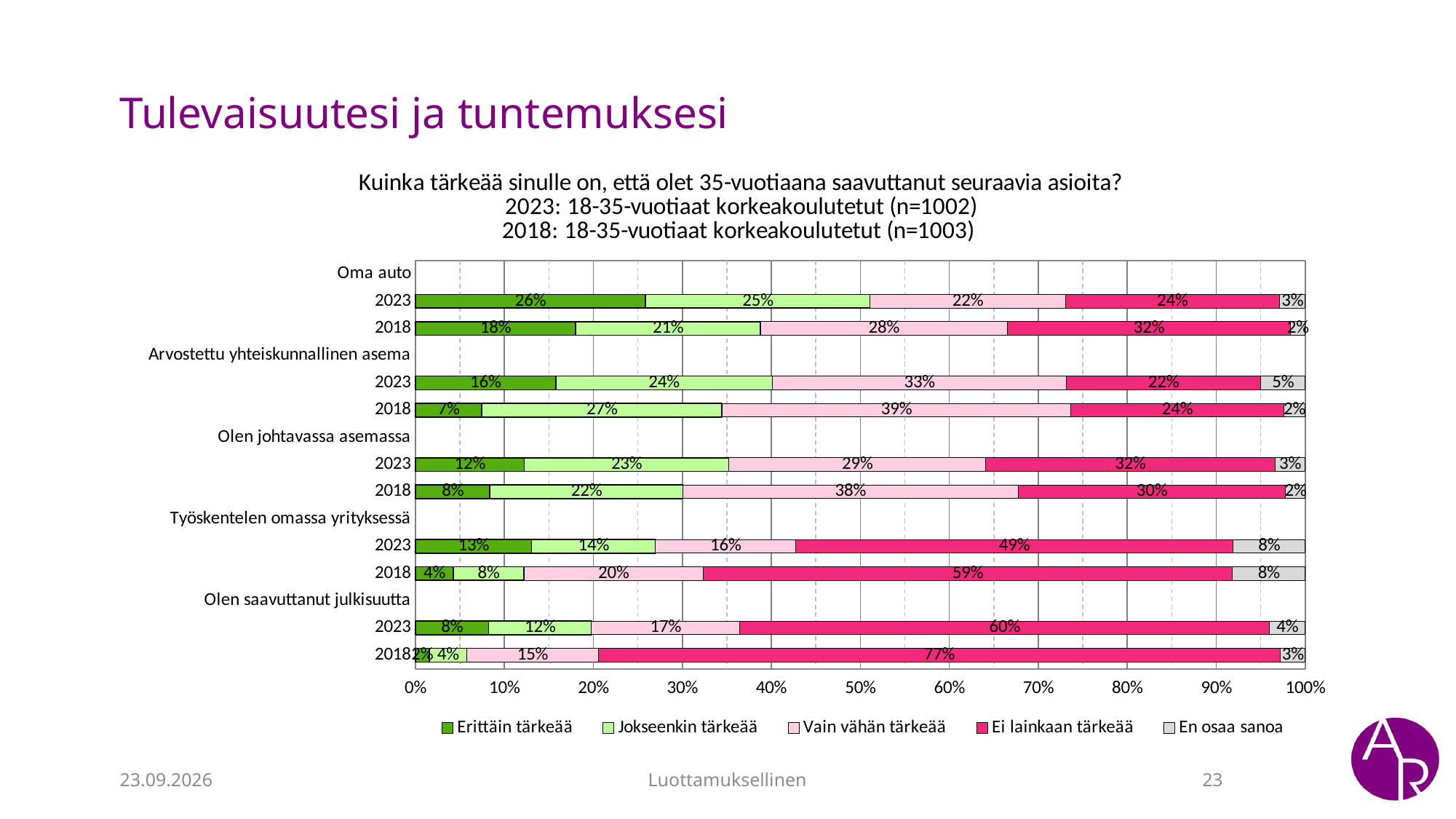
What is the 'Ei lainkaan tärkeää' value for 'Olen saavuttanut julkisuutta' in 2018? 77% How many items (statements) are compared in the chart? 5 Which is larger: the 'Jokseenkin tärkeää' value for 'Oma auto' in 2023 or in 2018? 2023 Which item has the highest 'Erittäin tärkeää' value in 2023? Oma auto Which item has the lowest 'Erittäin tärkeää' value in 2018? Olen saavuttanut julkisuutta What is the 'Erittäin tärkeää' value for 'Oma auto' in 2023? 26% What is the 'Vain vähän tärkeää' value for 'Arvostettu yhteiskunnallinen asema' in 2018? 39% What kind of chart is shown on the slide? Stacked bar chart What is the difference between the 'Ei lainkaan tärkeää' values for 'Työskentelen omassa yrityksessä' in 2018 and 2023? 10% What is the 'En osaa sanoa' value for 'Työskentelen omassa yrityksessä' in 2023? 8% How many series does the legend list? 5 Which legend entry is shown in dark green? Erittäin tärkeää